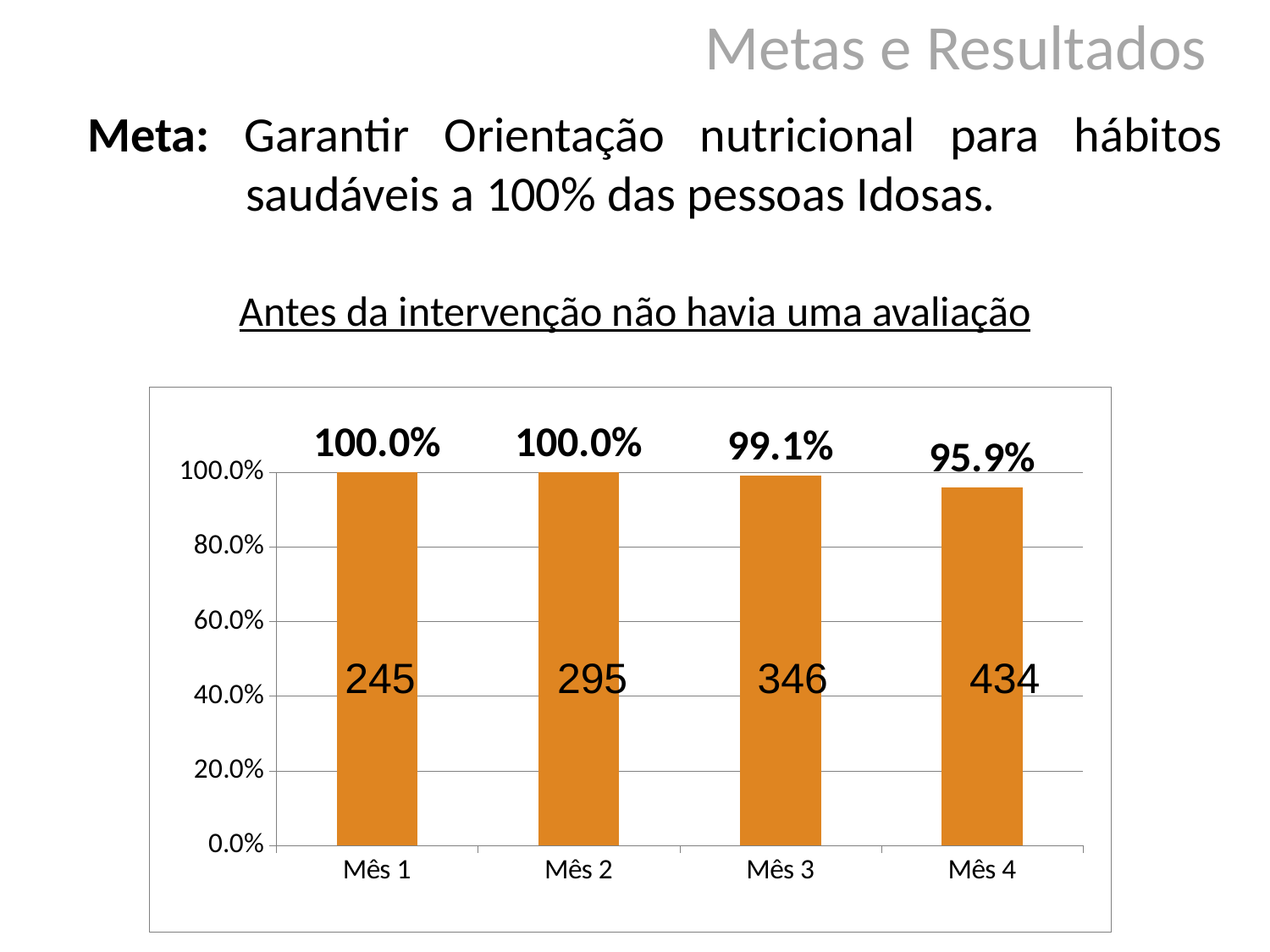
Do the percentage values rise or fall from Mês 2 to Mês 4? Fall Which month has the lowest percentage value? Mês 4 What number is printed inside the bar for Mês 2? 295 What kind of chart is shown on the slide? Bar chart Which has a higher percentage value, Mês 2 or Mês 4? Mês 2 What number is printed inside the bar for Mês 4? 434 What is the percentage value shown for Mês 4? 95.9% What is the difference between the percentage values for Mês 3 and Mês 4? 3.2% What is the percentage value shown for Mês 3? 99.1% What colour are the bars in the chart? Orange What is the difference between the numbers printed inside the bars for Mês 4 and Mês 1? 189 How many months (categories) are shown on the chart? 4